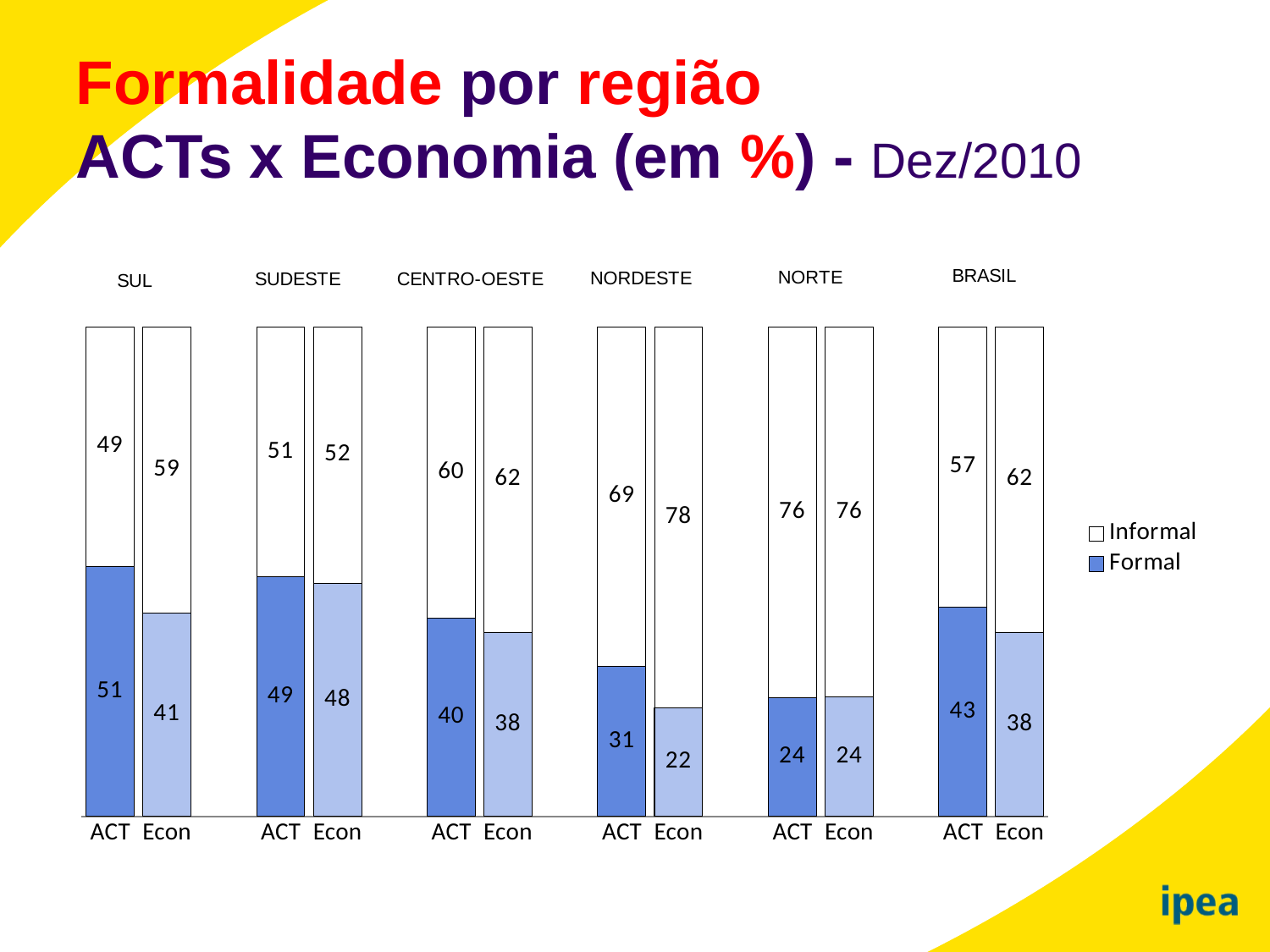
How many regional groups are shown on the chart? 6 Which is larger in the CENTRO-OESTE region, the Formal value for ACT or for Econ? ACT Which legend entry is shown in blue? Formal What kind of chart is shown on the slide? Stacked bar chart What is the total of the ACT stacked bar in the NORDESTE region? 100 Which region has the highest Formal value for Econ? SUDESTE What is the Informal value for Econ in the NORDESTE region? 78 Which region has the lowest Formal value for ACT? NORTE What is the difference between the Formal values for ACT and Econ in the SUL region? 10 How many series does the legend list? 2 What is the Formal value for Econ in the BRASIL group? 38 What is the Formal value for ACT in the SUL region? 51